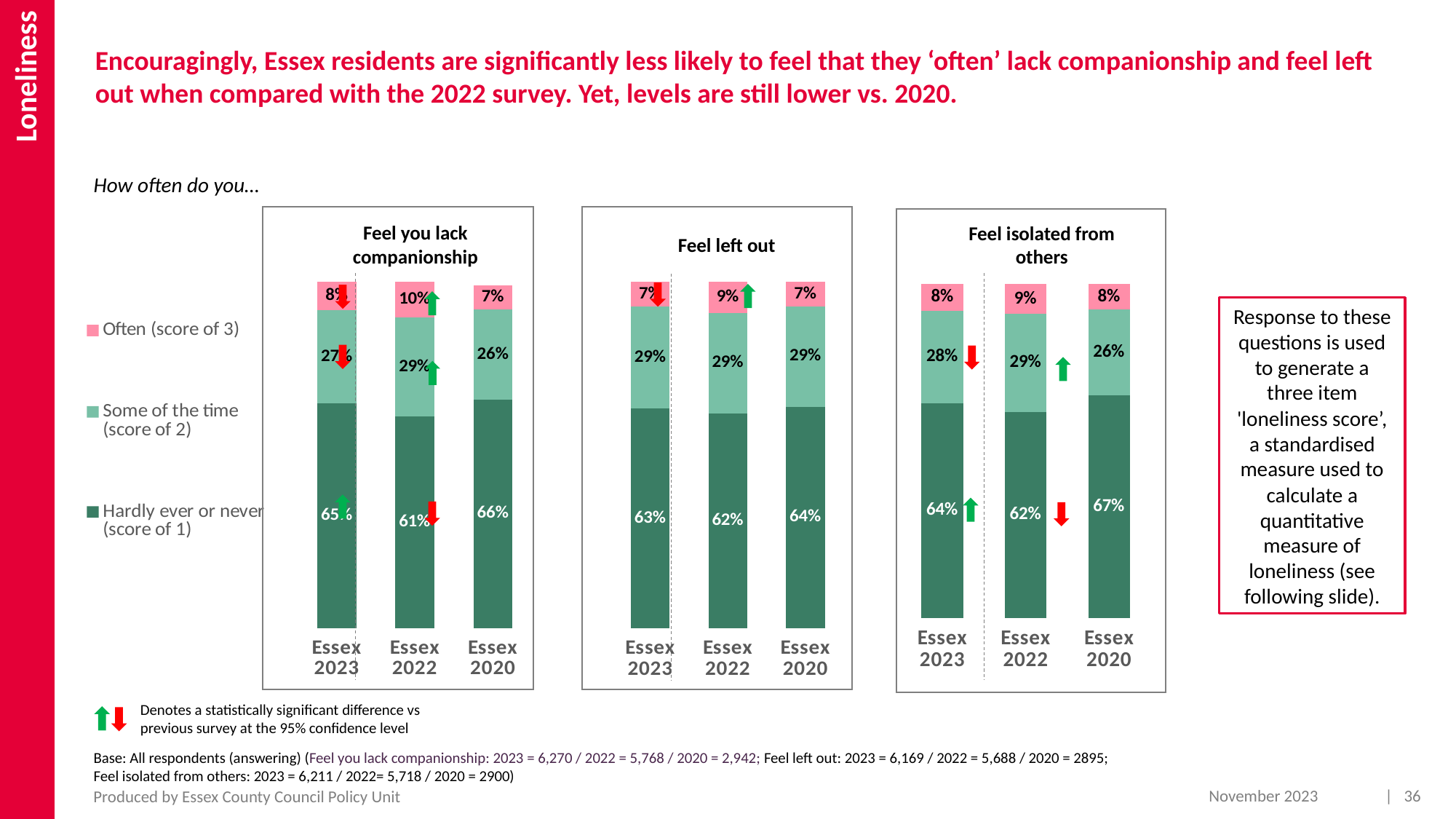
In the 'Feel left out' chart, what is the total of the three segments for Essex 2020? 100% How many survey years (bars) are shown in the 'Feel left out' chart? 3 In the 'Feel you lack companionship' chart, what is the 'Some of the time (score of 2)' value for Essex 2022? 29% In the 'Feel isolated from others' chart, what is the 'Hardly ever or never (score of 1)' value for Essex 2020? 67% In the 'Feel you lack companionship' chart, which year has the lowest 'Hardly ever or never (score of 1)' value? Essex 2022 In the 'Feel left out' chart, what percentage of Essex 2022 respondents answered 'Often (score of 3)'? 9% Which colour represents 'Often (score of 3)' in the legend? Pink In the 'Feel isolated from others' chart, is the 'Some of the time (score of 2)' value larger for Essex 2022 or Essex 2020? Essex 2022 What type of chart is used for 'Feel you lack companionship'? Stacked bar chart In the 'Feel isolated from others' chart, which year has the highest 'Hardly ever or never (score of 1)' value? Essex 2020 How many series does the legend list for the charts? 3 In the 'Feel left out' chart, what is the difference between the 'Often (score of 3)' values for Essex 2022 and Essex 2023? 2 percentage points